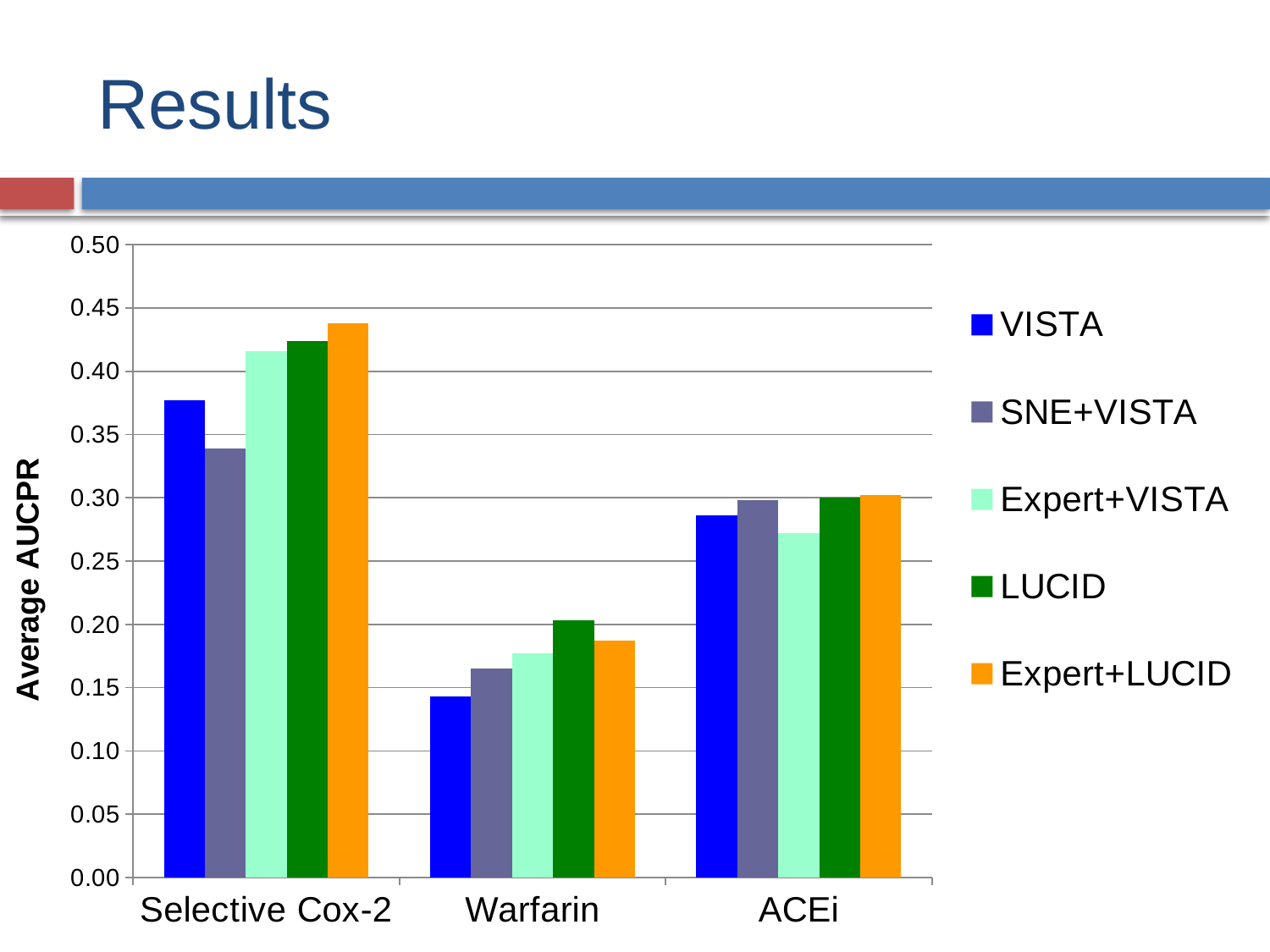
What kind of chart is shown on the slide? bar chart How many series does the legend list? 5 How many categories are shown on the x axis? 3 What is the label of the y axis? Average AUCPR Is the value for VISTA on Selective Cox-2 greater or less than 0.35? greater For Warfarin, which is larger: LUCID or Expert+LUCID? LUCID Which series has the lowest value for Warfarin? VISTA Which series has the lowest value for ACEi? Expert+VISTA Is the value for VISTA on Warfarin greater or less than 0.15? less Which series has the lowest value for Selective Cox-2? SNE+VISTA Which series has the highest value for Warfarin? LUCID Which series has the highest value for Selective Cox-2? Expert+LUCID